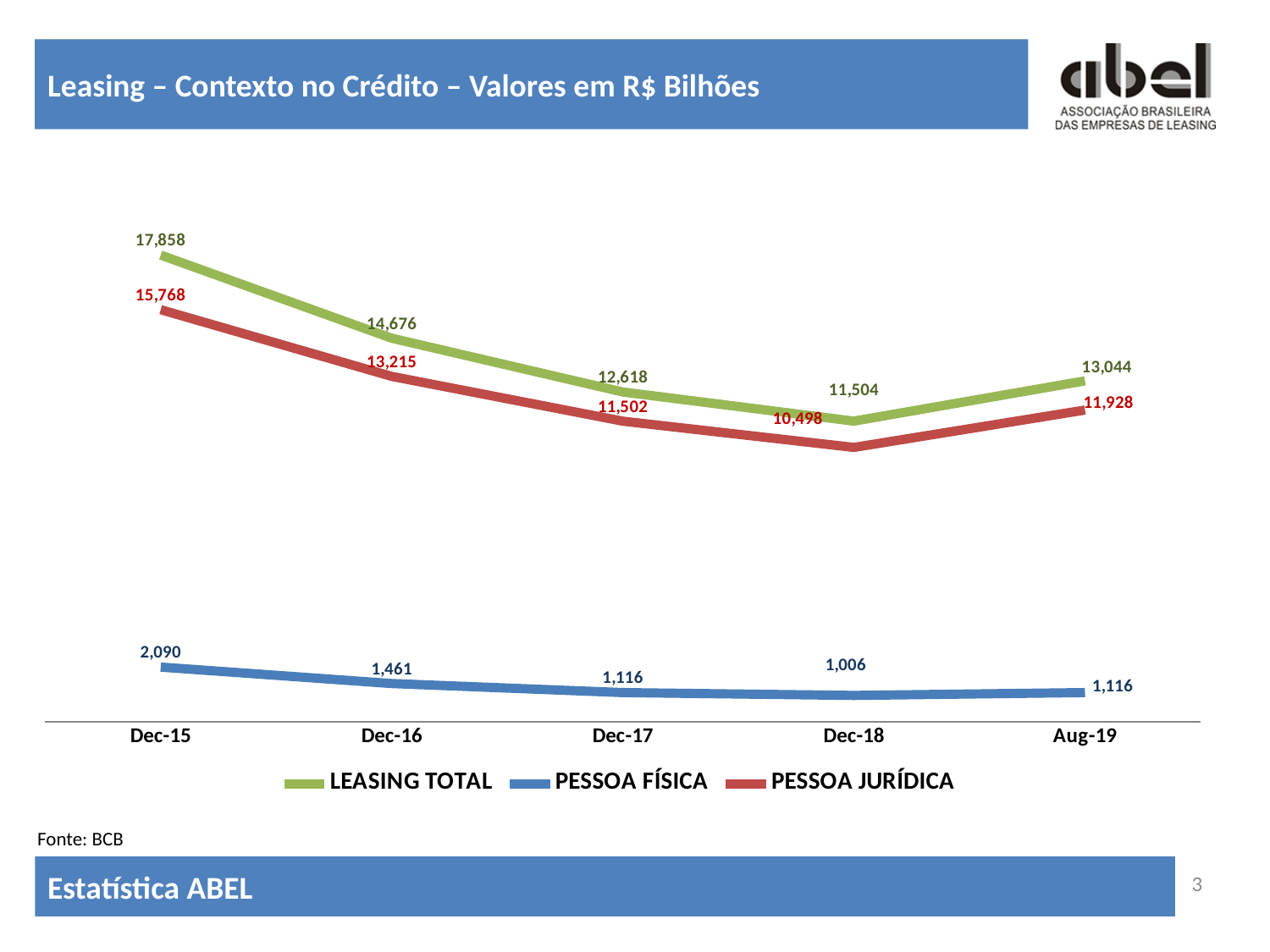
At which period is LEASING TOTAL lowest? Dec-18 What is the value of PESSOA JURÍDICA at Dec-18? 10,498 How many series does the legend list? 3 At which period is PESSOA FÍSICA highest? Dec-15 How many periods are shown on the x axis? 5 What is the value of PESSOA FÍSICA at Dec-16? 1,461 Which is larger, PESSOA JURÍDICA at Dec-16 or PESSOA JURÍDICA at Aug-19? Dec-16 By how much did LEASING TOTAL change from Dec-15 to Dec-16? 3,182 What kind of chart is shown on the slide? Line chart What is the value of LEASING TOTAL at Aug-19? 13,044 What is the difference between LEASING TOTAL and PESSOA JURÍDICA at Dec-17? 1,116 What is the value of LEASING TOTAL at Dec-15? 17,858